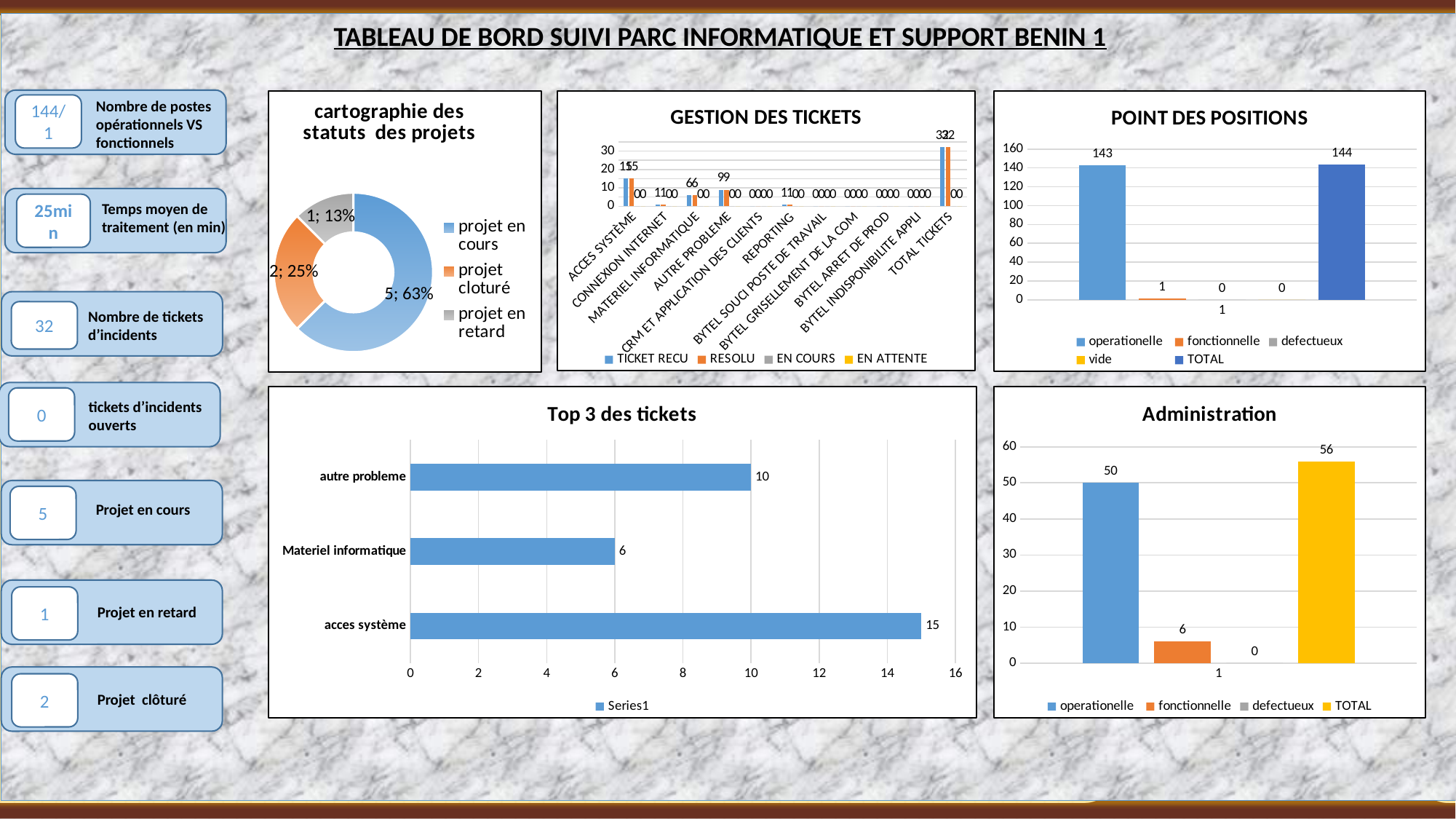
In the 'Administration' chart, what is the value for fonctionnelle? 6 How many series does the legend of the 'POINT DES POSITIONS' chart list? 5 In the 'POINT DES POSITIONS' chart, what is the value for TOTAL? 144 In the 'Top 3 des tickets' chart, which category has the lowest value? Materiel informatique In the 'Top 3 des tickets' chart, what is the difference between acces système and autre probleme? 5 In the 'cartographie des statuts des projets' chart, what share does 'projet en cours' have? 63% What kind of chart is 'Top 3 des tickets'? bar chart In the 'Top 3 des tickets' chart, what is the value for acces système? 15 In the 'Administration' chart, which is larger, operationelle or TOTAL? TOTAL How many slices does the 'cartographie des statuts des projets' chart have? 3 How many series does the legend of the 'GESTION DES TICKETS' chart list? 4 In the 'POINT DES POSITIONS' chart, what is the value for operationelle? 143